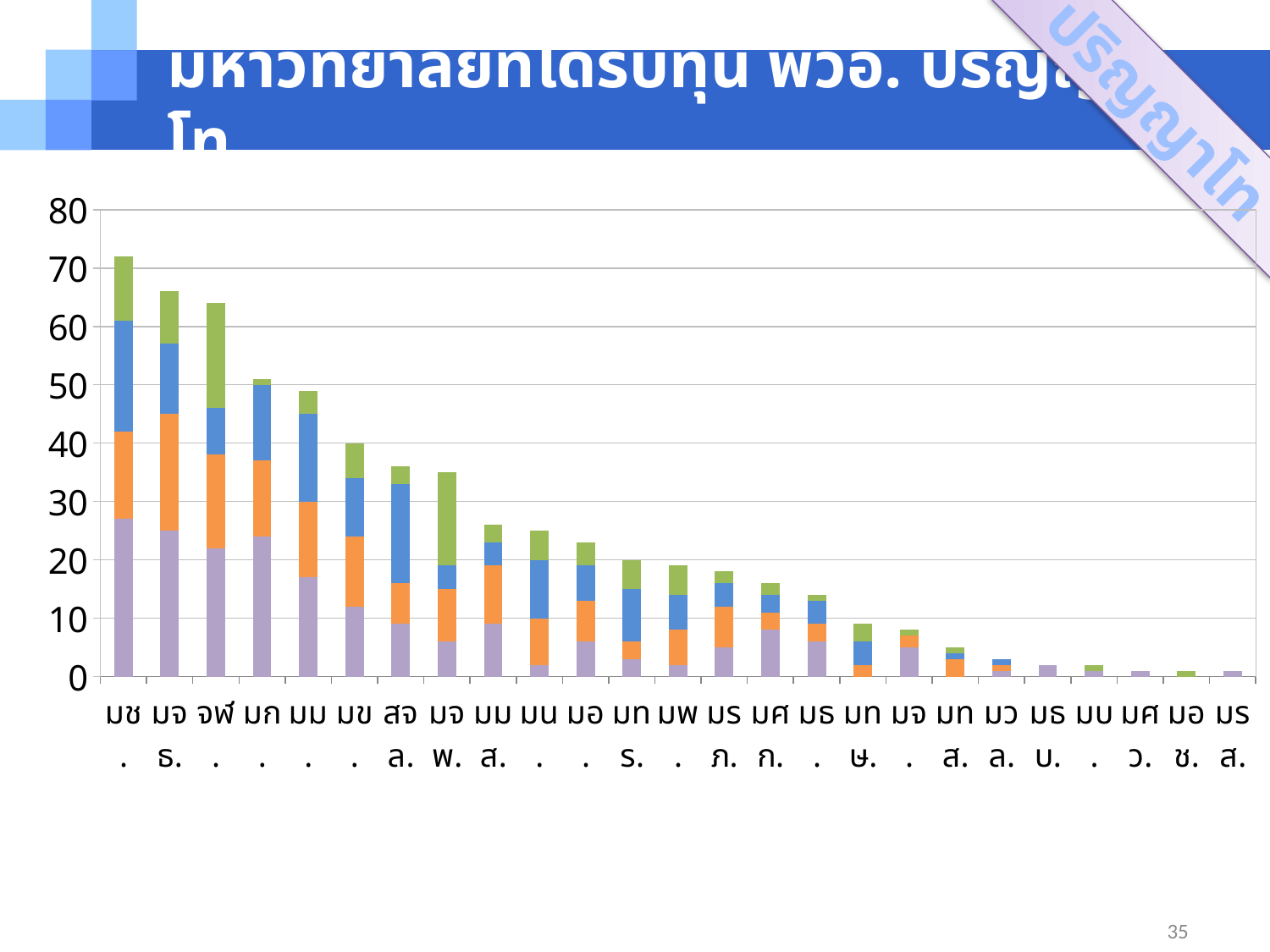
Which university has the highest total bar? มช. How many universities (categories) are shown on the x axis? 25 Is the total value for มวล. greater or less than 10? less Which has the larger total bar, มช. or มจธ.? มช. Is the total value for มน. greater or less than 20? greater Which has the larger total bar, จฬ. or มก.? จฬ. Which has the larger total bar, มม. or มข.? มม. Is the total value for สจล. greater or less than 40? less What kind of chart is shown on the slide? Stacked bar chart How many differently coloured segments are stacked in each bar? 4 Do the total bar heights generally rise or fall from left to right along the x axis? Fall